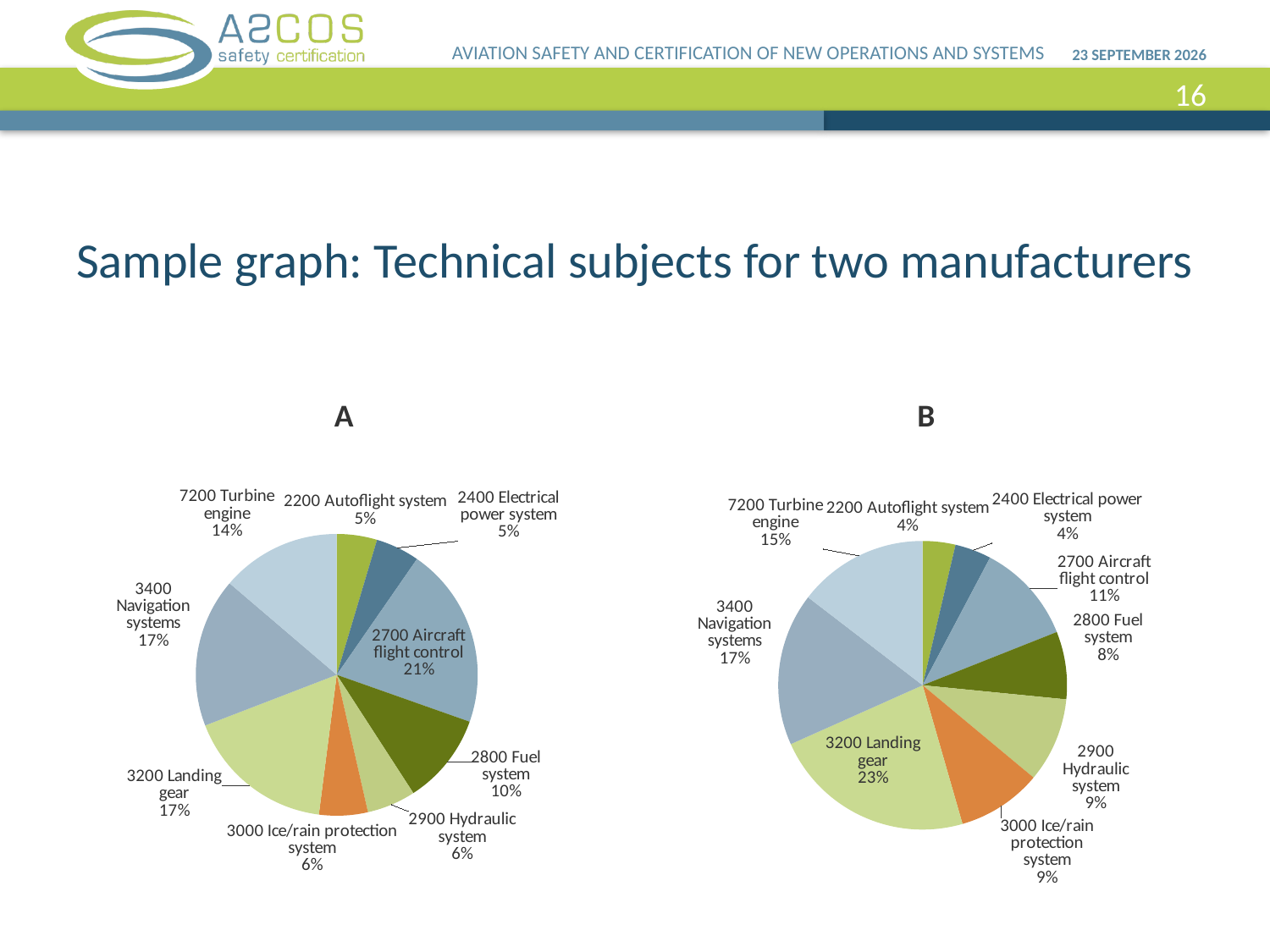
In chart B, what is the combined share of 2900 Hydraulic system and 3000 Ice/rain protection system? 18% What kind of chart is chart A? pie chart In chart B, what share does 3200 Landing gear have? 23% In chart A, what share does 2700 Aircraft flight control have? 21% How many slices does chart B have? 9 In chart A, which is larger: the share of 2800 Fuel system or the share of 2900 Hydraulic system? 2800 Fuel system In chart B, what is the share for 2800 Fuel system? 8% What is the difference between the share of 2700 Aircraft flight control in chart A and in chart B? 10 percentage points In chart B, which category has the largest share? 3200 Landing gear In chart A, which category has the largest share? 2700 Aircraft flight control In chart A, what is the share for 7200 Turbine engine? 14% What is the title of the slide containing the two pie charts? Sample graph: Technical subjects for two manufacturers